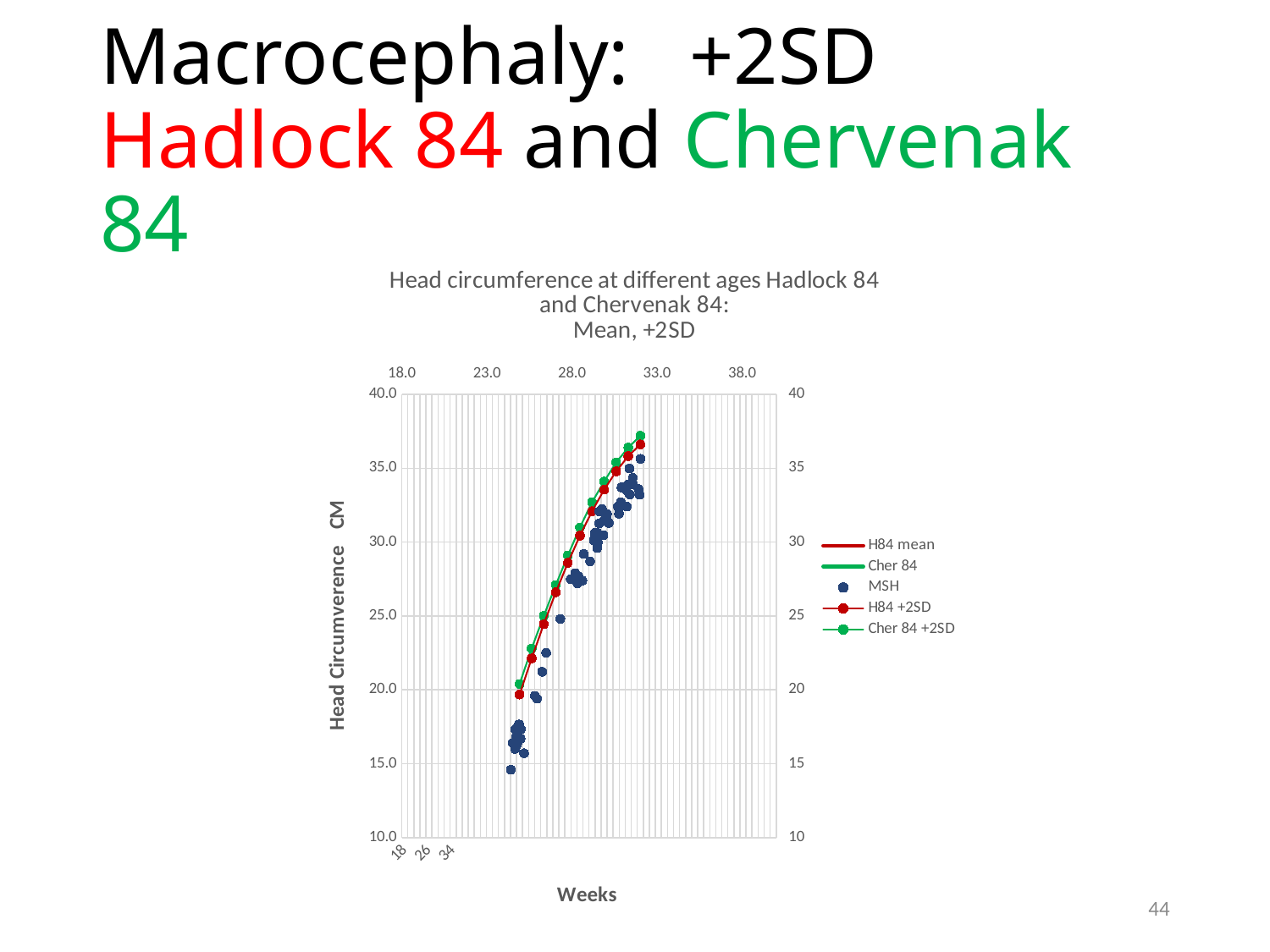
Is the lowest value of the H84 +2SD series greater or less than 25? less Is the highest MSH point greater or less than 40? less Do the head circumference values rise or fall as the weeks increase along the x axis? rise Is the lowest MSH point greater or less than 20? less Which series are listed in the chart's legend? H84 mean, Cher 84, MSH, H84 +2SD, Cher 84 +2SD At the highest week plotted, which series reaches a higher value: Cher 84 +2SD or H84 +2SD? Cher 84 +2SD How many series does the chart's legend list? 5 What is the title of the chart's vertical axis? Head Circumverence CM What kind of chart is shown on the slide? scatter chart